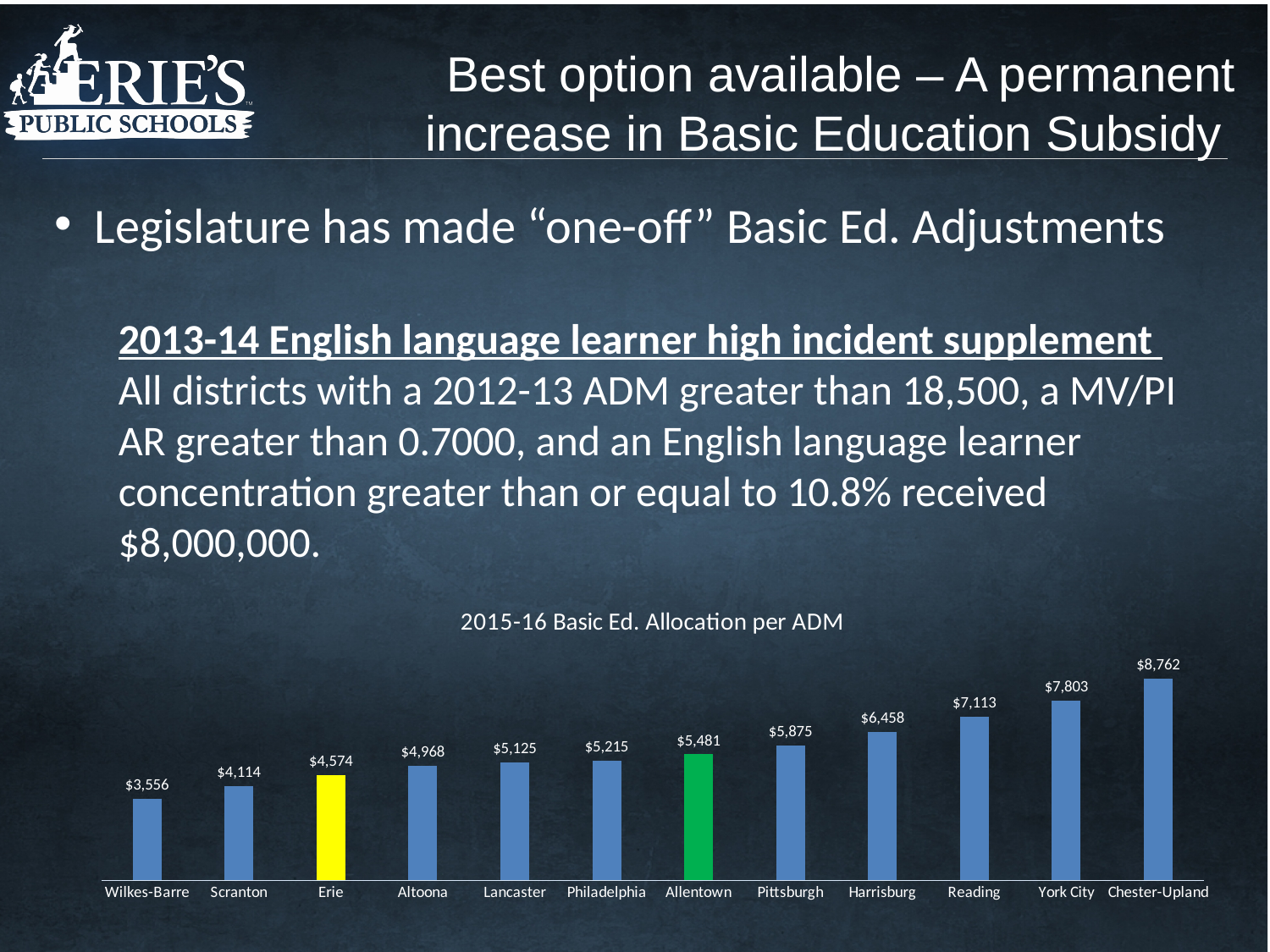
What is the 2015-16 Basic Ed. Allocation per ADM for York City? $7,803 How many districts are shown in the 2015-16 Basic Ed. Allocation per ADM chart? 12 What type of chart is used to show the 2015-16 Basic Ed. Allocation per ADM? Bar chart Which district has the highest 2015-16 Basic Ed. Allocation per ADM? Chester-Upland Which district's bar is coloured yellow in the 2015-16 Basic Ed. Allocation per ADM chart? Erie Do the values in the 2015-16 Basic Ed. Allocation per ADM chart rise or fall from left to right? Rise Which district has the lowest 2015-16 Basic Ed. Allocation per ADM? Wilkes-Barre What is the 2015-16 Basic Ed. Allocation per ADM for Erie? $4,574 What is the difference between the Basic Ed. Allocation per ADM for Chester-Upland and Erie? $4,188 What is the 2015-16 Basic Ed. Allocation per ADM for Pittsburgh? $5,875 Which has a larger Basic Ed. Allocation per ADM, Harrisburg or Lancaster? Harrisburg What is the difference between the Basic Ed. Allocation per ADM for Allentown and Philadelphia? $266